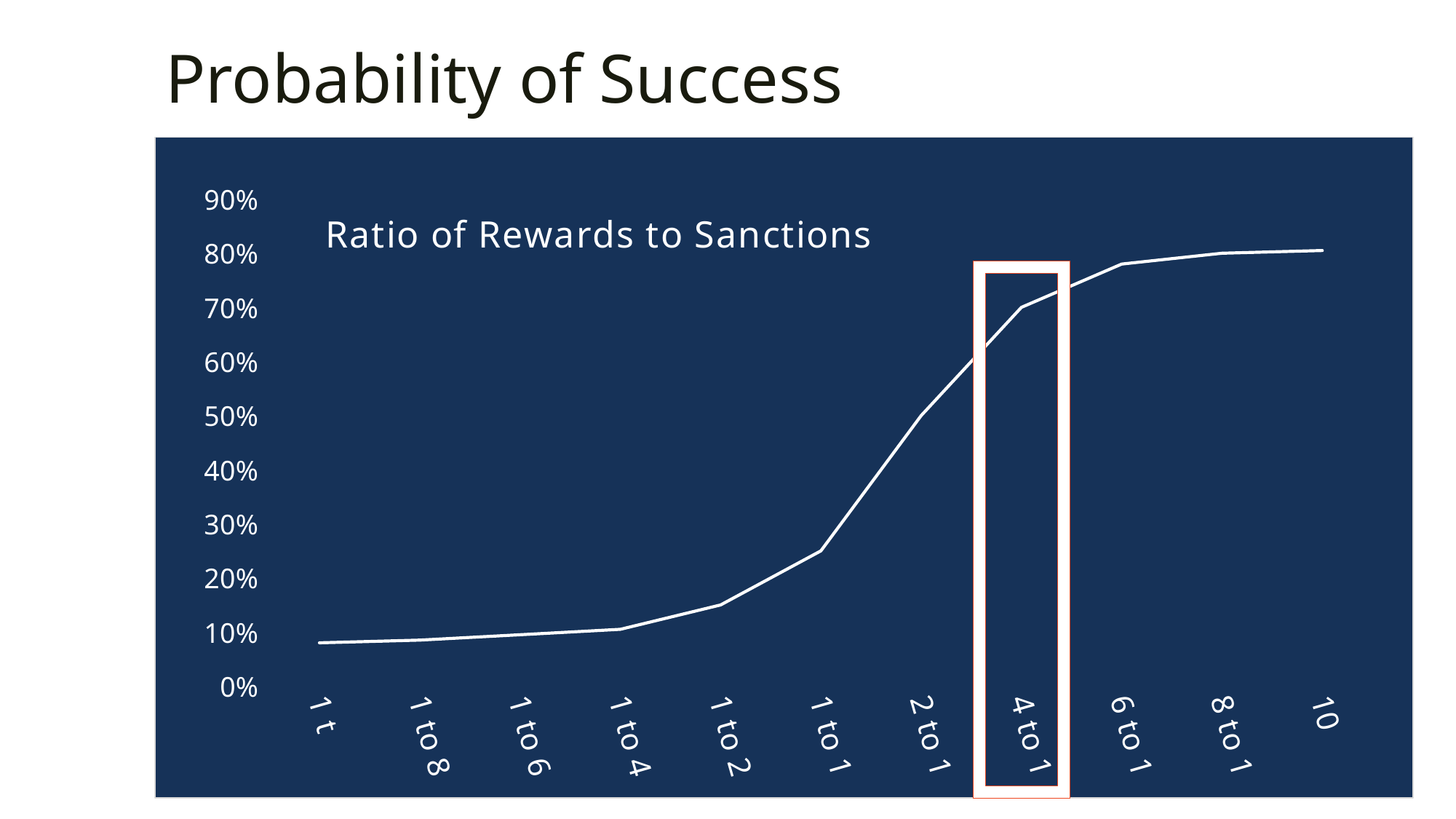
Which has the larger value, 1 to 2 or 4 to 1? 4 to 1 Is the value for 6 to 1 greater or less than 70%? greater Is the value for 1 to 1 greater or less than 30%? less Is the value for 4 to 1 greater or less than 60%? greater What is the title printed inside the chart area? Ratio of Rewards to Sanctions Which x-axis category is highlighted with a rectangular outline? 4 to 1 Do the values rise or fall as you move from left to right along the x axis? rise How many data points are plotted on the line? 11 Which has the larger value, 1 to 1 or 2 to 1? 2 to 1 What kind of chart is shown on the slide? line chart